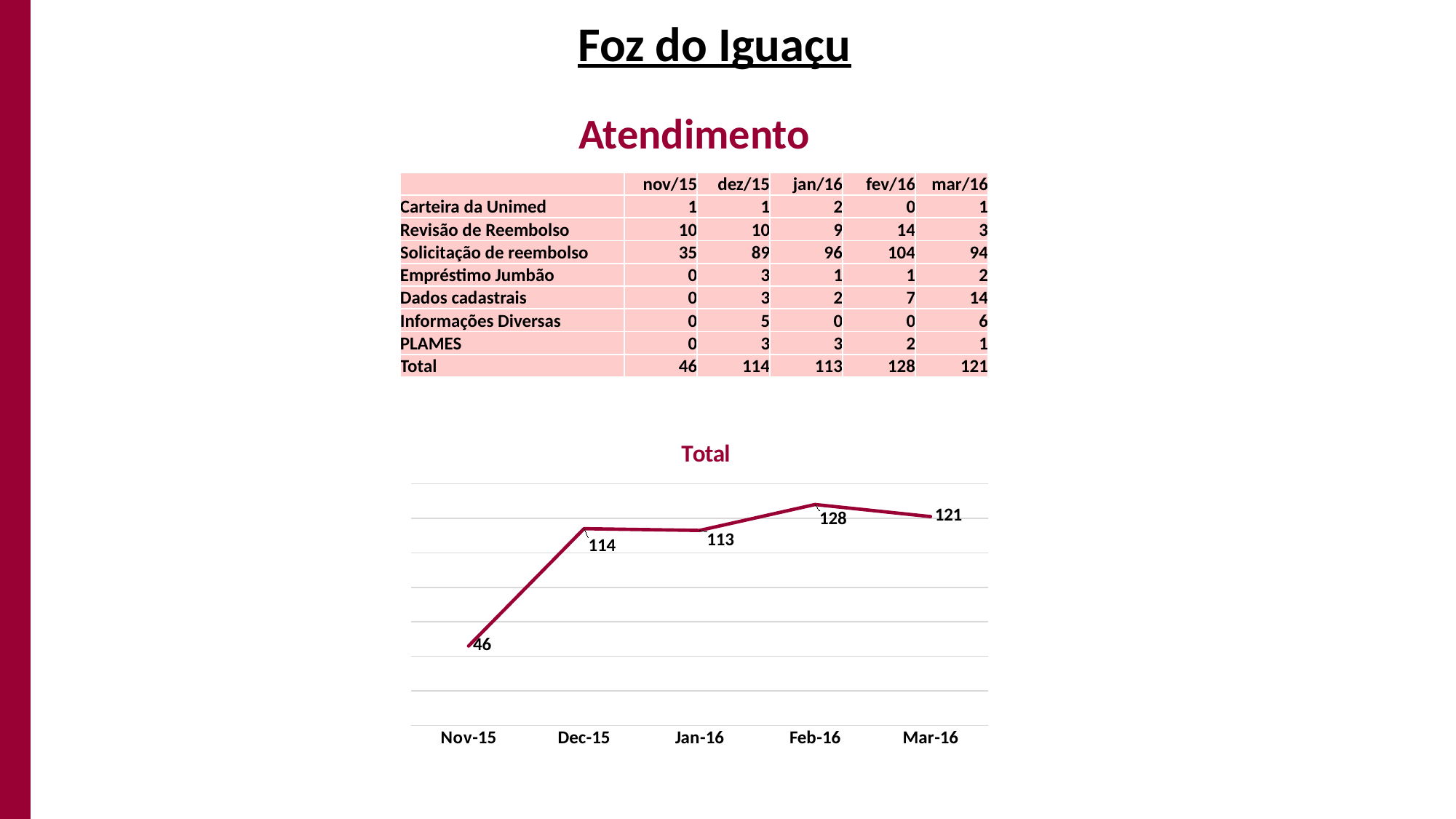
What kind of chart is the Total chart? line chart What is the value for Mar-16 in the Total chart? 121 Does the value in the Total chart rise or fall from Nov-15 to Dec-15? rise Which is larger in the Total chart, the value for Dec-15 or the value for Feb-16? Feb-16 What is the difference between the Dec-15 and Nov-15 values in the Total chart? 68 What is the title of the chart on the slide? Total What is the value for Nov-15 in the Total chart? 46 Which month has the lowest value in the Total chart? Nov-15 How many data points are plotted in the Total chart? 5 What is the difference between the Feb-16 and Mar-16 values in the Total chart? 7 Which month has the highest value in the Total chart? Feb-16 What is the value for Feb-16 in the Total chart? 128